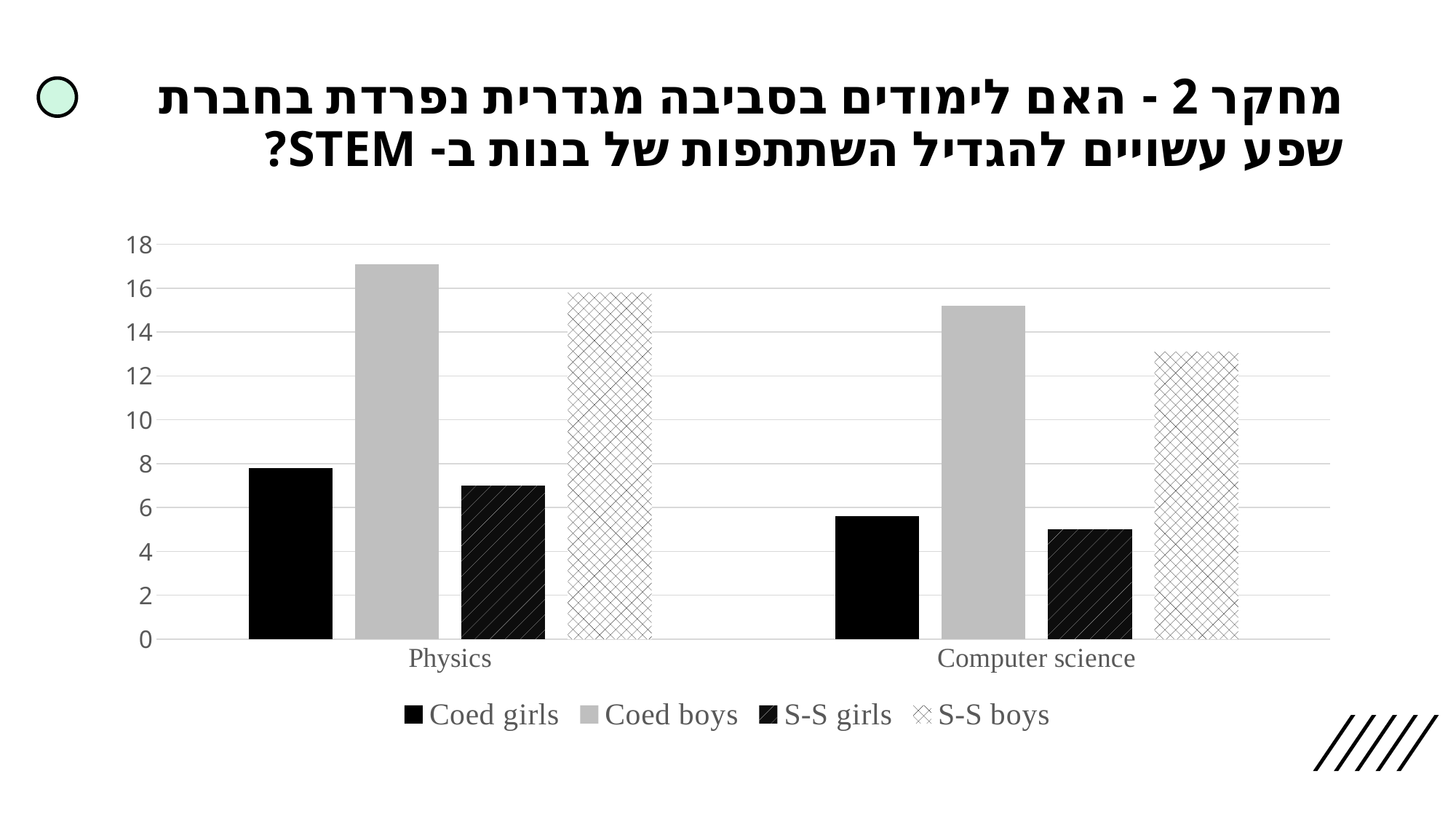
For Coed boys, which category has the larger value: Physics or Computer science? Physics How many categories are shown on the x axis? 2 Which series has the lowest bar in the Computer science category? S-S girls Which series has the highest bar in the Physics category? Coed boys How many series does the legend list? 4 Which is larger in Physics: Coed boys or S-S boys? Coed boys Which series is shown with a cross-hatched pattern in the legend? S-S boys Is the value for S-S girls in Computer science greater or less than 6? less What kind of chart is shown on the slide? bar chart Is the value for S-S boys in Computer science greater or less than 14? less Is the value for Coed boys in Computer science greater or less than 14? greater